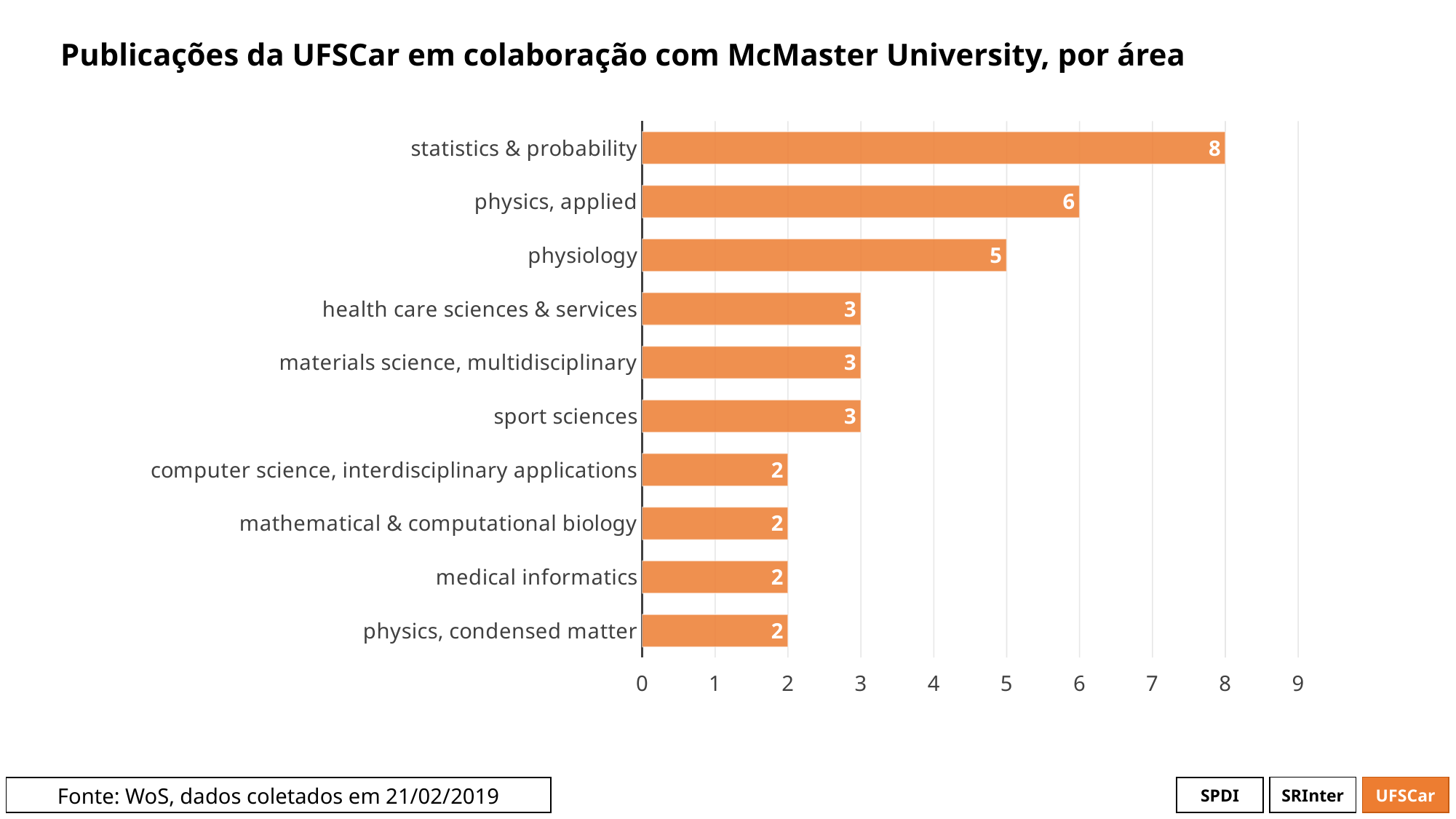
Which category has the highest value? statistics & probability What is the value for physiology? 5 What is the value for health care sciences & services? 3 What is the value for statistics & probability? 8 Which is larger, the value for physics, applied or the value for physiology? physics, applied What is the difference between the values for statistics & probability and physics, applied? 2 How many categories are shown in the chart? 10 What is the title of the chart? Publicações da UFSCar em colaboração com McMaster University, por área Is the value for physics, applied greater or less than 5? greater What is the value for medical informatics? 2 What kind of chart is shown on the slide? bar chart What is the difference between the values for physiology and sport sciences? 2